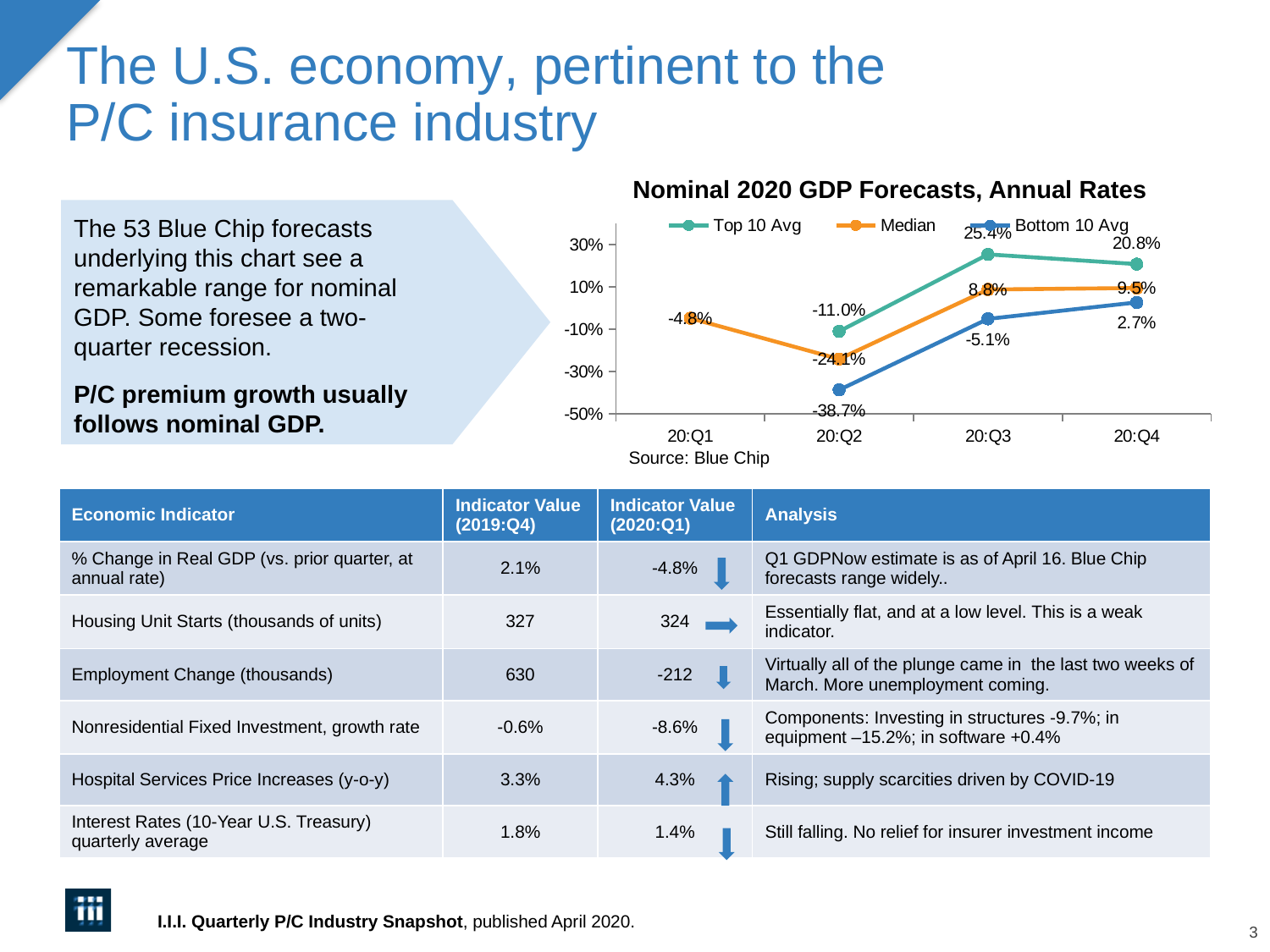
What is the title of the chart? Nominal 2020 GDP Forecasts, Annual Rates How many quarters are plotted along the x axis of the chart? 4 In which quarter does the Bottom 10 Avg series reach its lowest value? 20:Q2 In which quarter does the Top 10 Avg series reach its highest value? 20:Q3 How many series does the chart legend list? 3 What is the Median forecast for 20:Q4? 9.5% What is the Bottom 10 Avg forecast for 20:Q2? -38.7% What is the Top 10 Avg forecast for 20:Q3? 25.4% What is the difference between the Top 10 Avg and Bottom 10 Avg forecasts for 20:Q3? 30.5 percentage points Does the Median series rise or fall from 20:Q1 to 20:Q2? fall Which is larger for 20:Q4: the Median forecast or the Bottom 10 Avg forecast? Median What kind of chart is shown on the slide? line chart